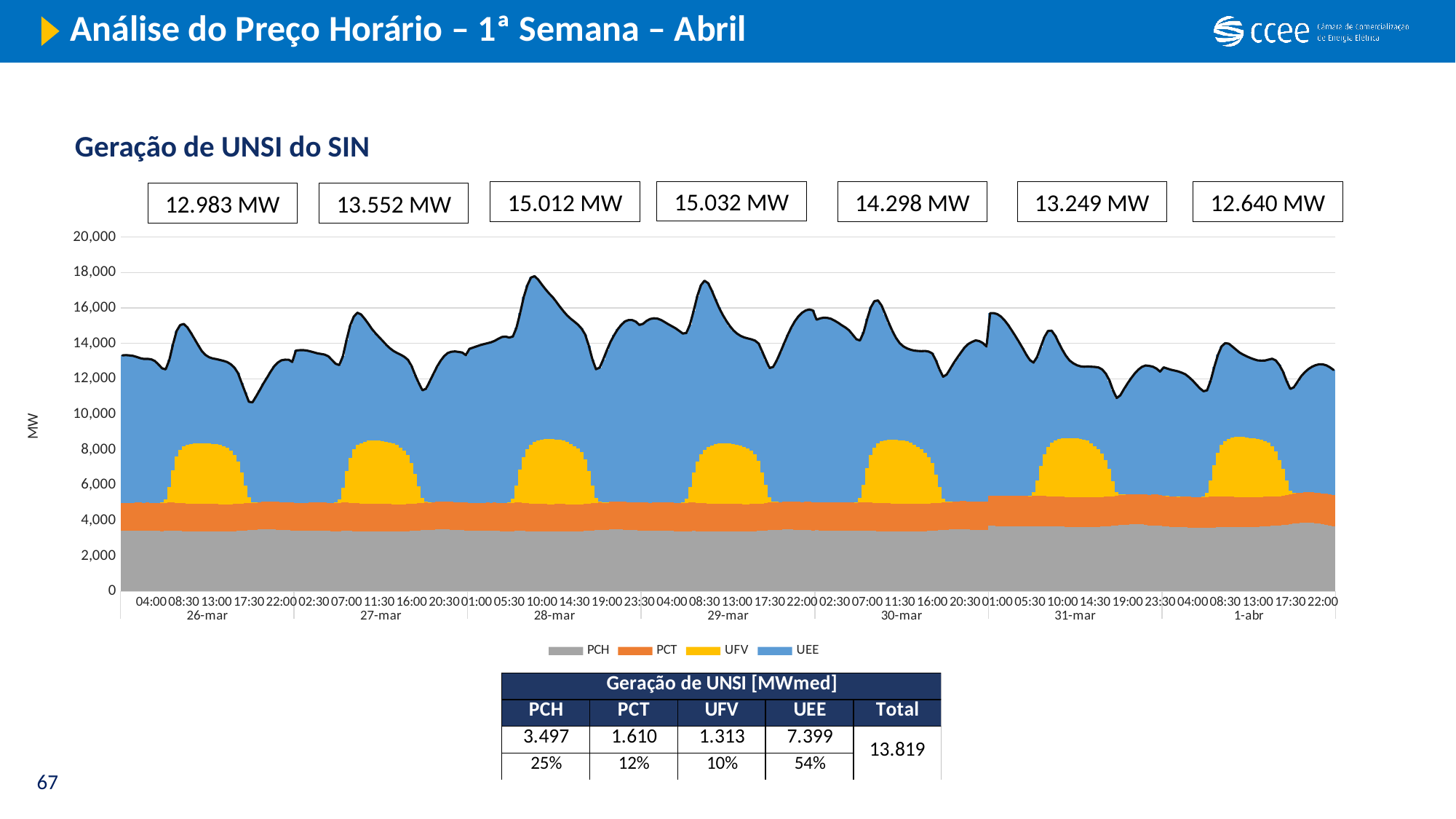
How many series does the legend of the 'Geração de UNSI do SIN' chart list? 4 Which day has the highest boxed value above the 'Geração de UNSI do SIN' chart? 29-mar Do the boxed daily values above the 'Geração de UNSI do SIN' chart rise or fall from 29-mar to 1-abr? fall Is the peak of the stacked total on 28-mar in the 'Geração de UNSI do SIN' chart greater or less than 16,000? greater What value is printed in the box above 26-mar on the 'Geração de UNSI do SIN' chart? 12.983 MW What value is printed in the box above 28-mar on the 'Geração de UNSI do SIN' chart? 15.012 MW Which day has the larger boxed value on the 'Geração de UNSI do SIN' chart, 27-mar or 31-mar? 27-mar What kind of chart is shown under the title 'Geração de UNSI do SIN'? stacked area chart Which day has the lowest boxed value above the 'Geração de UNSI do SIN' chart? 1-abr What is the difference between the boxed values for 29-mar and 1-abr on the 'Geração de UNSI do SIN' chart? 2.392 MW How many days are shown along the x axis of the 'Geração de UNSI do SIN' chart? 7 Which series is shown in yellow in the 'Geração de UNSI do SIN' chart? UFV